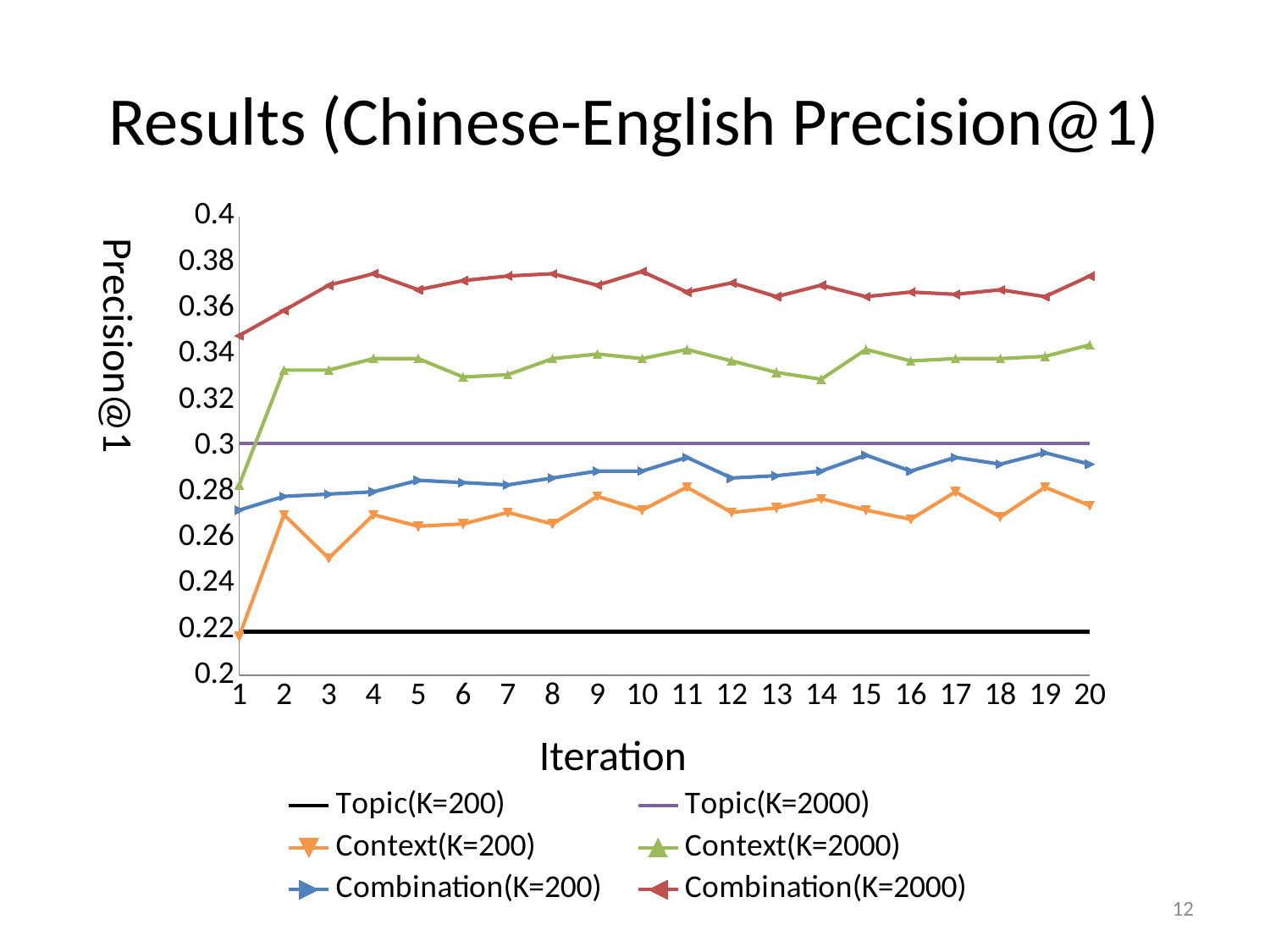
Does the Context(K=200) line rise or fall from iteration 1 to iteration 2? rise How many series does the legend list? 6 Is the value for Combination(K=2000) at iteration 10 greater or less than 0.36? greater What kind of chart is shown on the slide? line chart Is the value for Context(K=200) at iteration 3 greater or less than 0.26? less How many iterations are plotted along the x axis? 20 Which series has the lowest Precision@1 values across the iterations? Topic(K=200) What is the label of the x axis? Iteration Is the value for Context(K=2000) at iteration 1 greater or less than 0.3? less At iteration 2, which is larger: Context(K=2000) or Combination(K=200)? Context(K=2000) Which series has the highest Precision@1 values across the iterations? Combination(K=2000)